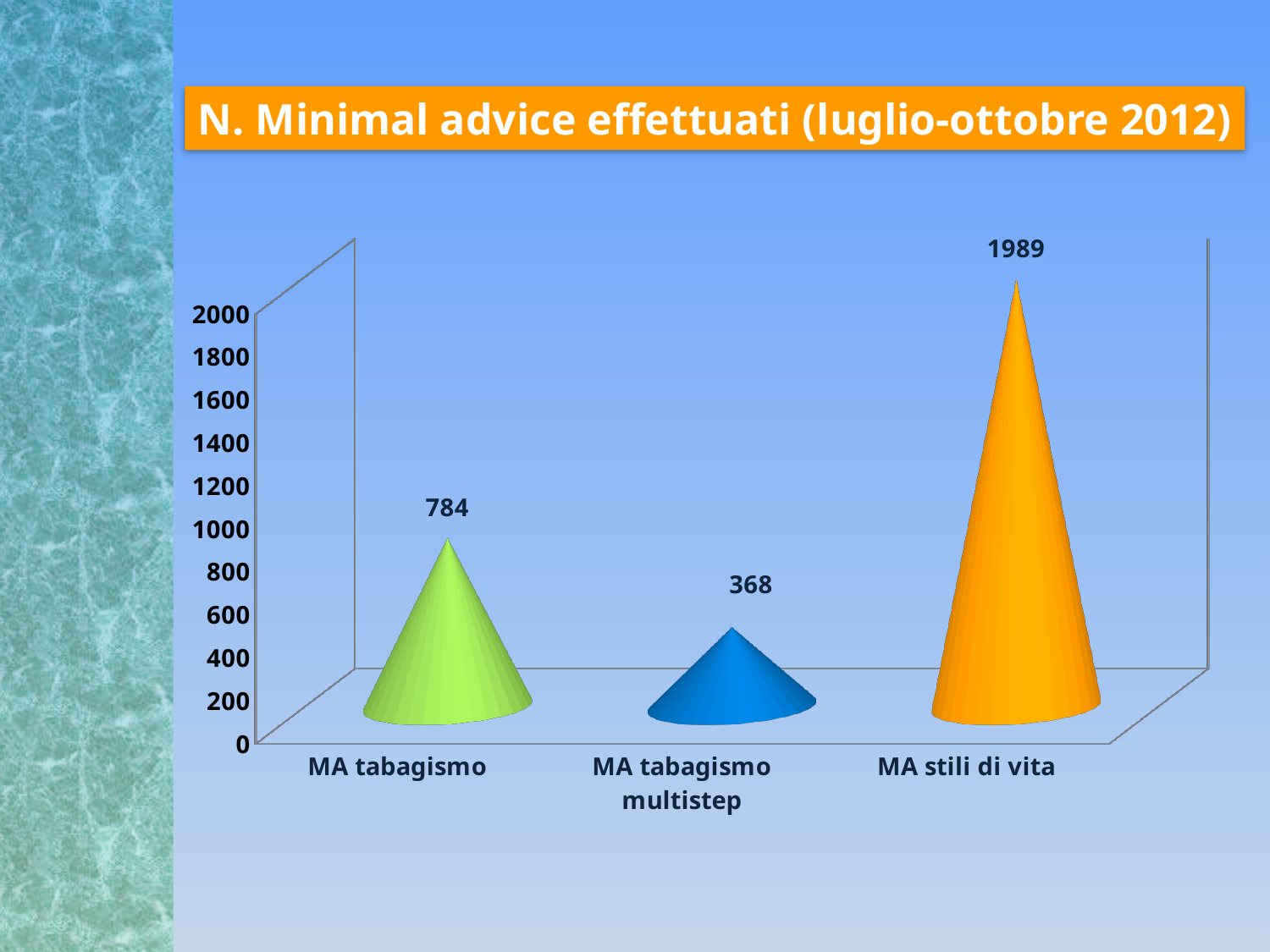
What is the title of the chart? N. Minimal advice effettuati (luglio-ottobre 2012) What kind of chart is shown on the slide? bar chart Which is larger, the value for MA tabagismo or the value for MA tabagismo multistep? MA tabagismo Which category has the highest value? MA stili di vita What is the difference between the values for MA stili di vita and MA tabagismo? 1205 What is the value for MA tabagismo? 784 What is the value for MA tabagismo multistep? 368 What is the value for MA stili di vita? 1989 How many categories are shown on the chart? 3 What is the difference between the values for MA tabagismo and MA tabagismo multistep? 416 Is the value for MA stili di vita greater or less than 1800? greater Which category has the lowest value? MA tabagismo multistep